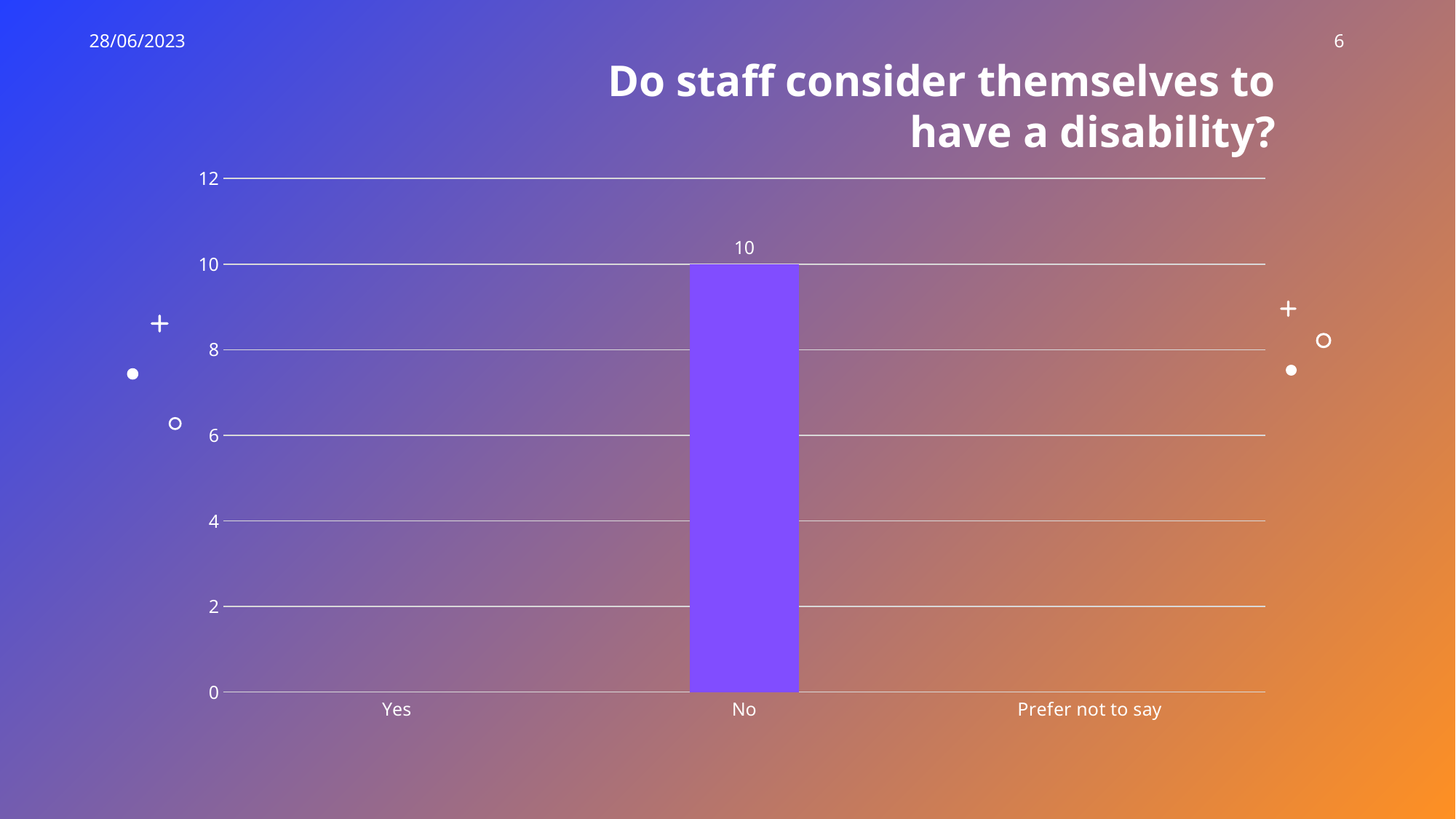
Is the value for "Prefer not to say" greater or less than 2? less What kind of chart is shown on the slide? Bar chart Which is larger, the value for "No" or the value for "Yes"? No Which category has the highest value in the chart? No How many categories are shown on the x axis of the chart? 3 Is the value for "Yes" greater or less than 2? less Which is larger, the value for "No" or the value for "Prefer not to say"? No What is the title of the chart? Do staff consider themselves to have a disability? What is the highest value shown on the y axis of the chart? 12 What is the value for "No" in the chart? 10 Is the value for "No" greater or less than 8? greater